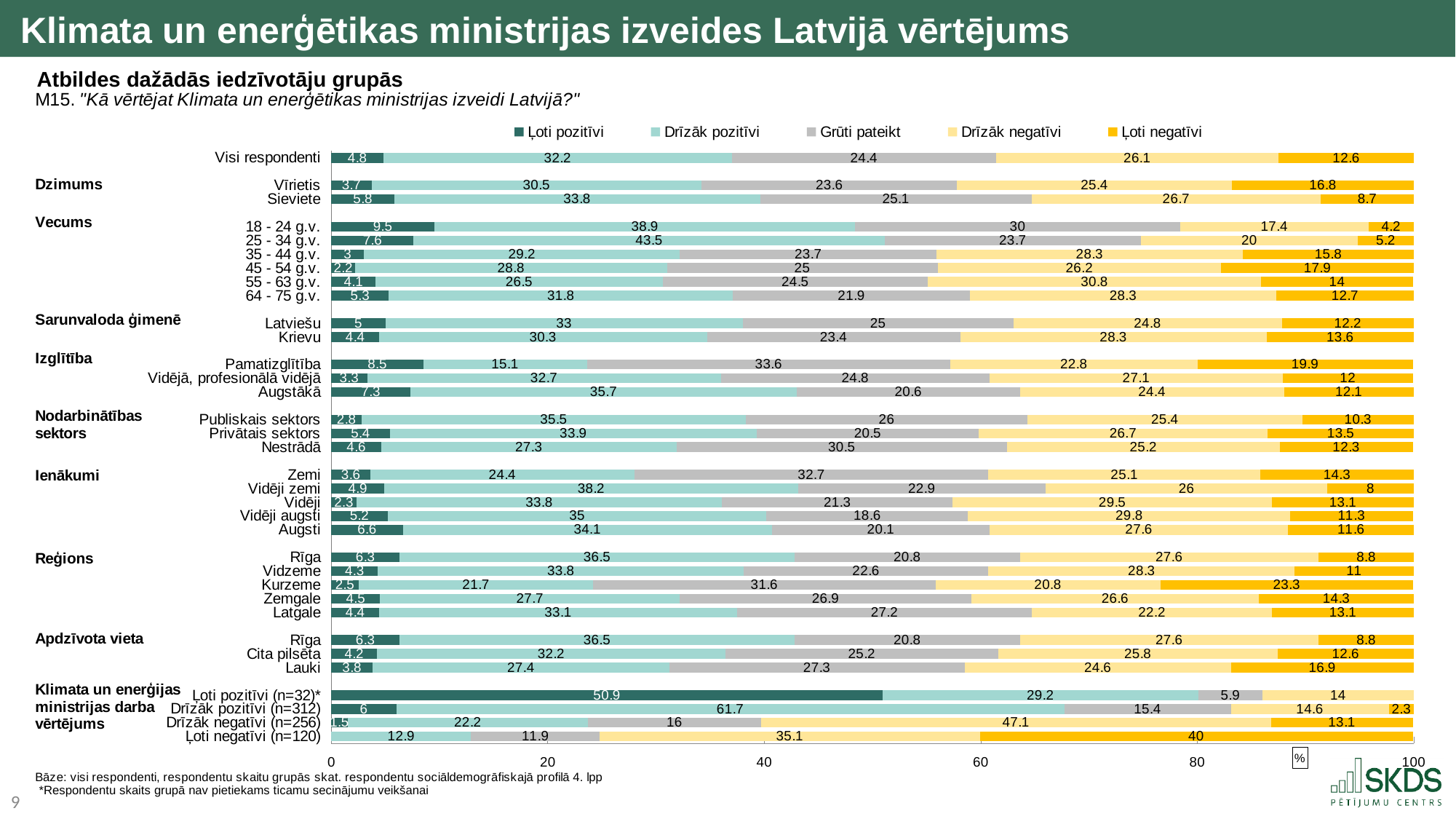
Among the age groups (Vecums), which has the highest "Ļoti pozitīvi" value? 18 - 24 g.v. What is the value of "Ļoti pozitīvi" for the group "Ļoti pozitīvi (n=32)*"? 50.9 What is the value of "Ļoti negatīvi" for Lauki? 16.9 How many series does the legend list? 5 What is the value of "Ļoti negatīvi" for Kurzeme? 23.3 Among the regions (Reģions), which has the lowest "Ļoti negatīvi" value? Rīga Which has the larger "Drīzāk negatīvi" value, Latviešu or Krievu? Krievu What is the value of "Drīzāk pozitīvi" for the 25 - 34 g.v. age group? 43.5 What is the difference between the "Ļoti negatīvi" values for Vīrietis and Sieviete? 8.1 What is the value of "Drīzāk pozitīvi" for "Visi respondenti"? 32.2 What kind of chart is shown on the slide? Stacked bar chart Among the education groups (Izglītība), which has the highest "Grūti pateikt" value? Pamatizglītība